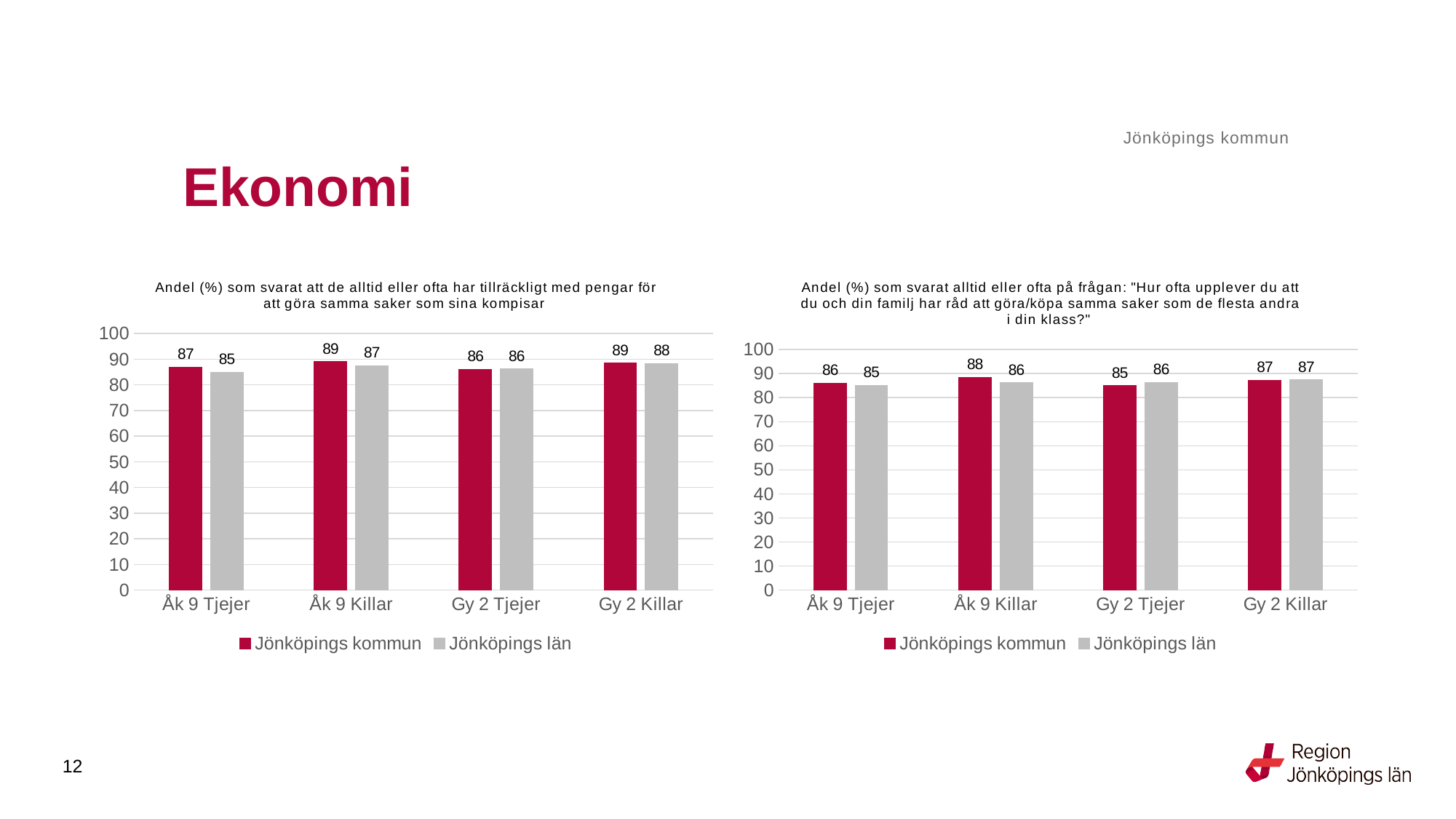
In the right chart, what is the value for Jönköpings kommun for Åk 9 Killar? 88 How many series does the legend of the left chart list? 2 What kind of chart is the right chart? bar chart In the right chart, what is the value for Jönköpings län for Gy 2 Tjejer? 86 How many categories are shown on the x axis of the right chart? 4 In the right chart, which is larger for Gy 2 Tjejer: Jönköpings kommun or Jönköpings län? Jönköpings län In the left chart, what is the difference between Jönköpings kommun and Jönköpings län for Åk 9 Killar? 2 In the left chart, which category has the highest value for Jönköpings län? Gy 2 Killar In the left chart, what is the value for Jönköpings län for Gy 2 Killar? 88 In the right chart, which category has the lowest value for Jönköpings kommun? Gy 2 Tjejer In the left chart, is the value for Jönköpings kommun for Gy 2 Tjejer greater or less than 80? greater In the left chart, what is the value for Jönköpings kommun for Åk 9 Tjejer? 87